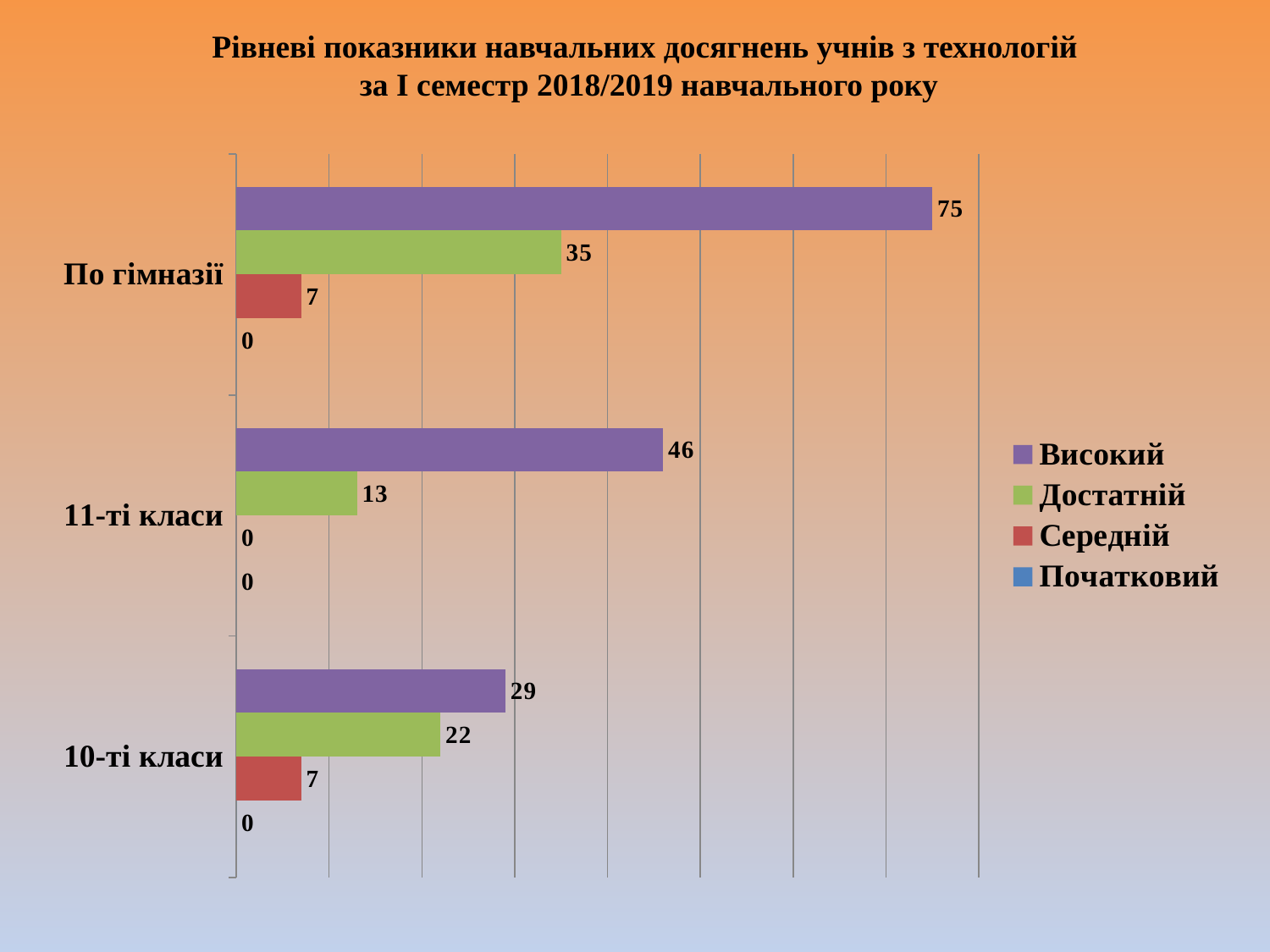
What is the difference between the Високий values for По гімназії and 11-ті класи? 29 What is the value for Середній in the 10-ті класи category? 7 Which category has the lowest value for Достатній? 11-ті класи How many categories are shown on the chart? 3 How many series does the legend list? 4 What kind of chart is shown on the slide? Bar chart Which is larger: Достатній for 10-ті класи or Достатній for 11-ті класи? 10-ті класи Which category has the highest value for Високий? По гімназії What is the value for Середній in the 11-ті класи category? 0 Which series is shown in green in the legend? Достатній What is the value for Достатній in the 11-ті класи category? 13 What is the value for Високий in the По гімназії category? 75